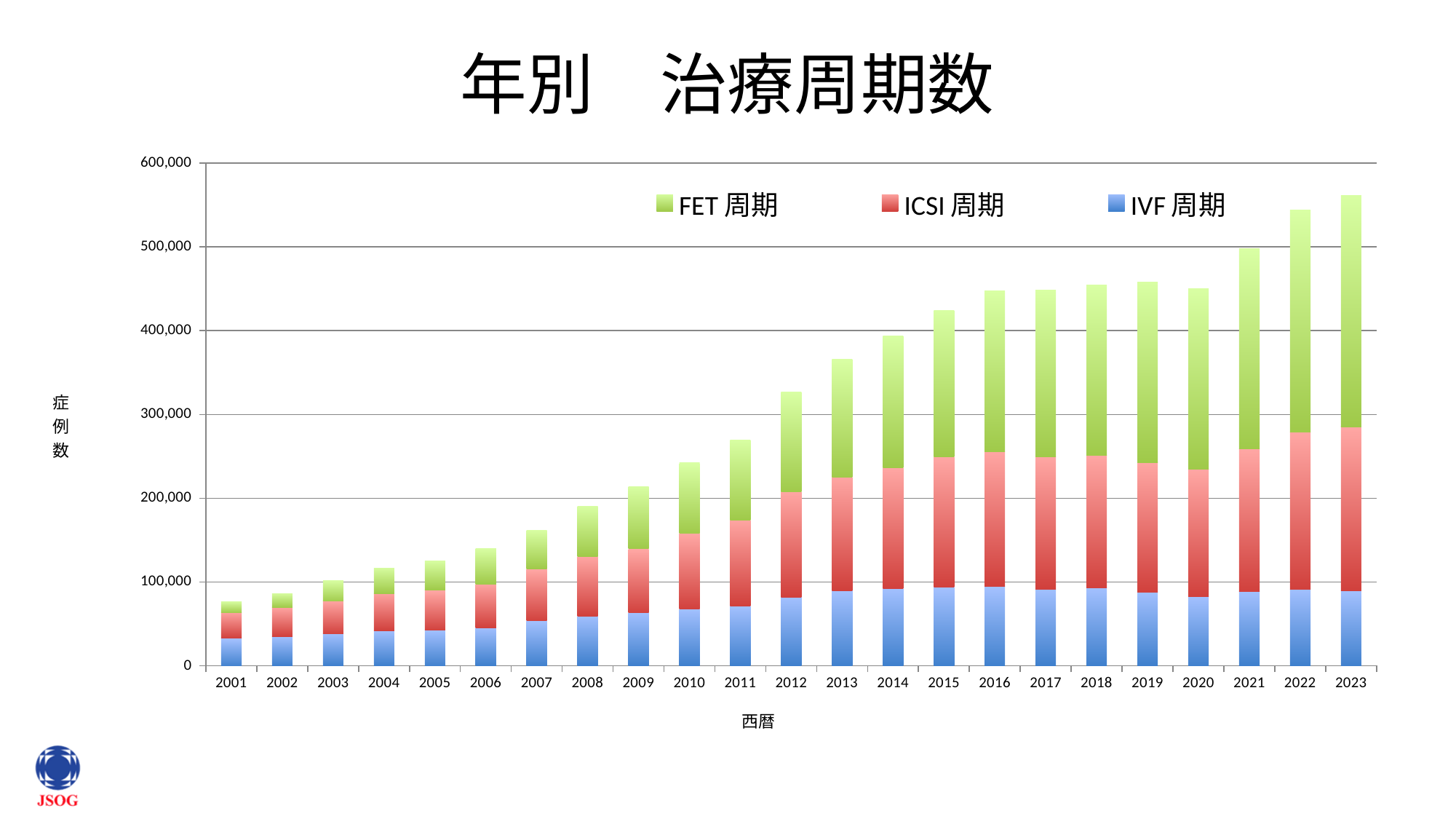
Is the total bar height for 2012 greater or less than 300,000? greater How many series does the legend list? 3 Which year has a larger total bar, 2020 or 2022? 2022 Is the total bar height for 2023 greater or less than 500,000? greater Which series is shown in green in the legend? FET 周期 What kind of chart is shown on the slide? Stacked bar chart What is the title of the chart? 年別 治療周期数 Which year has the lowest total number of treatment cycles? 2001 How many years are shown along the x axis of the chart? 23 Do the total treatment cycle counts generally rise or fall from 2001 to 2023? Rise Is the total bar height for 2001 greater or less than 100,000? less Which year has the highest total number of treatment cycles? 2023